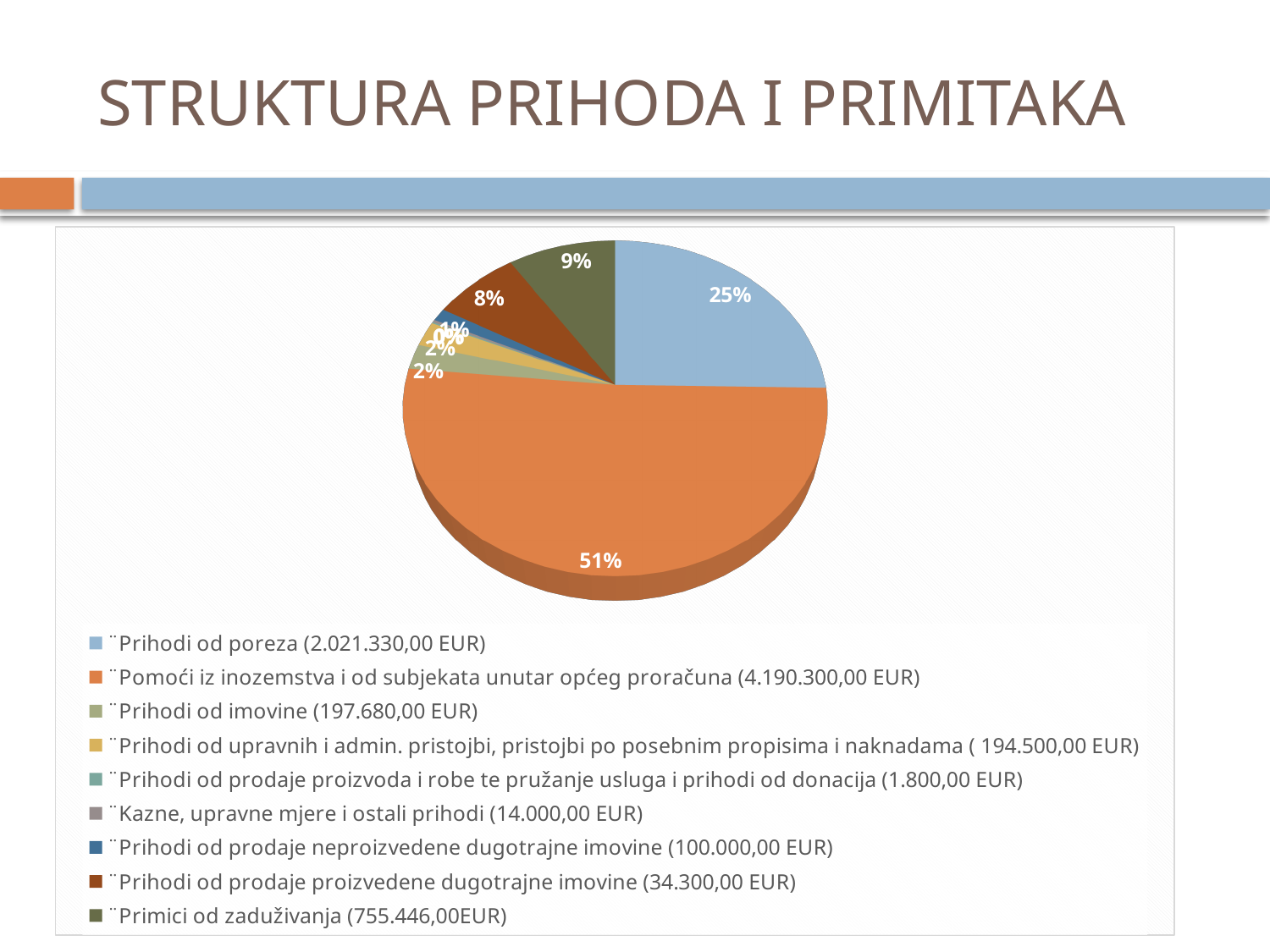
What colour is the slice for Pomoći iz inozemstva i od subjekata unutar općeg proračuna? orange What is the difference in percentage points between the Pomoći iz inozemstva slice (51%) and the Prihodi od poreza slice (25%)? 26% Which category has the largest slice of the pie? Pomoći iz inozemstva i od subjekata unutar općeg proračuna Which is larger, the slice for Prihodi od poreza or the slice for Pomoći iz inozemstva i od subjekata unutar općeg proračuna? Pomoći iz inozemstva i od subjekata unutar općeg proračuna What amount in EUR does the legend give for Prihodi od poreza? 2.021.330,00 EUR What kind of chart is shown on the slide? pie chart What amount in EUR does the legend give for Primici od zaduživanja? 755.446,00EUR How many categories does the legend of the pie chart list? 9 What share of the pie does Pomoći iz inozemstva i od subjekata unutar općeg proračuna have? 51% What is the title of the slide containing the chart? STRUKTURA PRIHODA I PRIMITAKA What share of the pie does Prihodi od poreza have? 25% What share of the pie does Primici od zaduživanja have? 9%